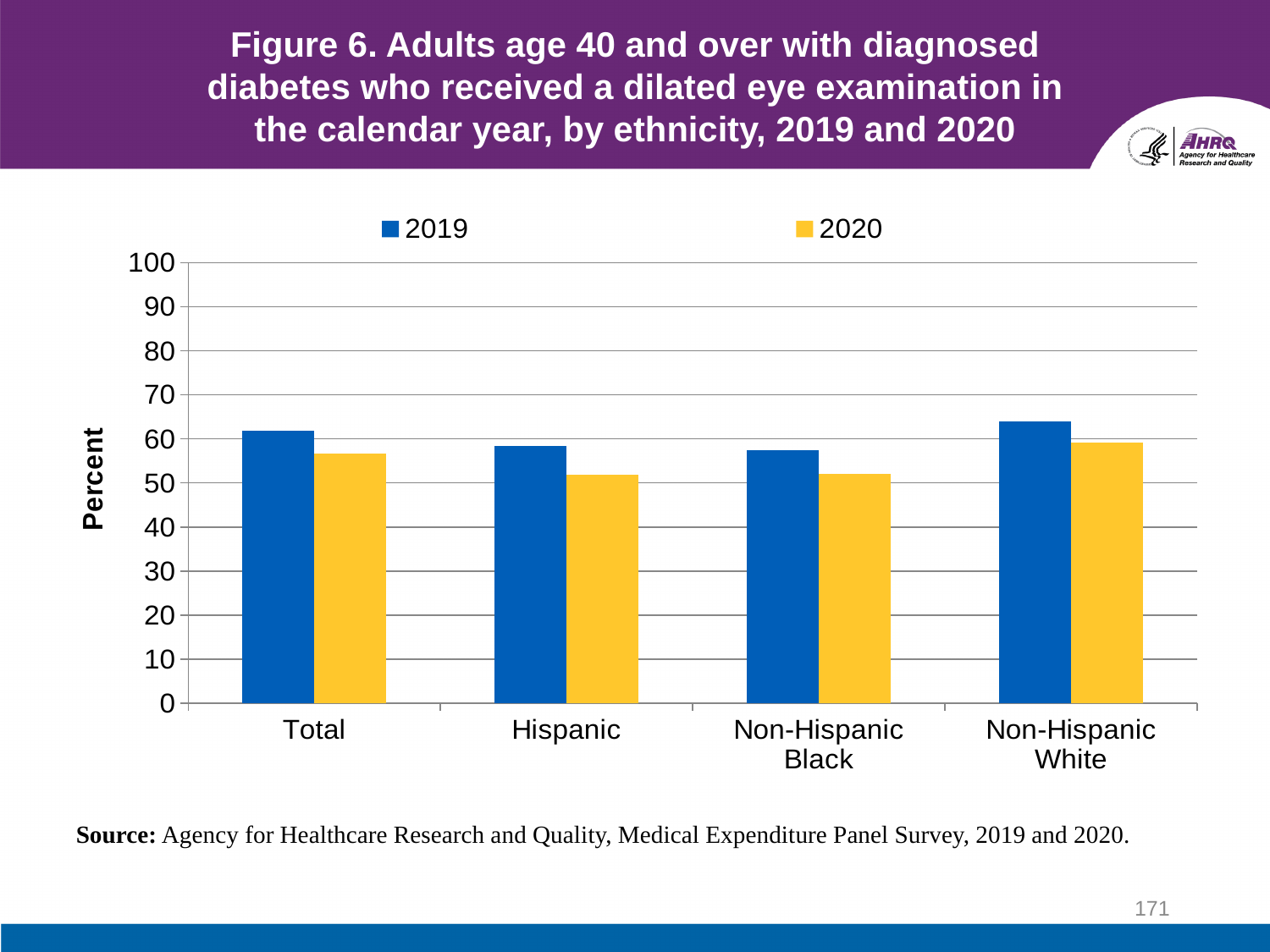
Is the 2019 value for Non-Hispanic White greater or less than 60? greater Which category has the highest value for 2019? Non-Hispanic White Is the 2020 value for Non-Hispanic Black greater or less than 60? less For the Total category, which year has the larger value, 2019 or 2020? 2019 Is the 2020 value for Hispanic greater or less than 50? greater What is the label on the y axis? Percent What kind of chart is shown on the slide? Bar chart Which category has the highest value for 2020? Non-Hispanic White How many ethnicity categories are shown on the x axis? 4 For 2020, which is larger: Non-Hispanic White or Hispanic? Non-Hispanic White How many series does the legend list? 2